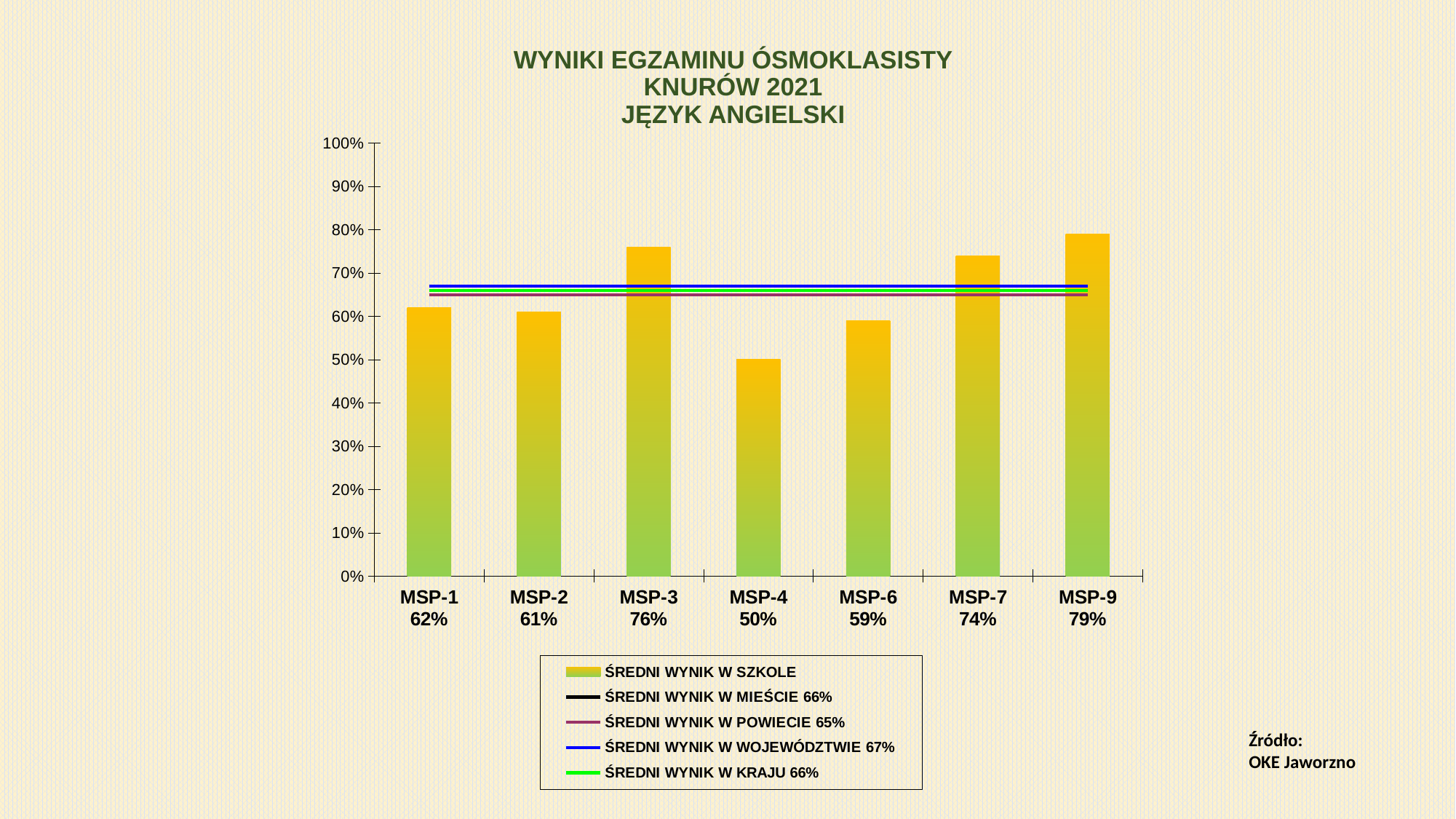
What is the average school result for MSP-3? 76% What is the difference between the results of MSP-9 and MSP-4? 29% What is the average school result for MSP-6? 59% Which school has the highest average result? MSP-9 Which school has the lowest average result? MSP-4 What kind of chart is shown on the slide? bar chart What is the average result in the voivodeship (ŚREDNI WYNIK W WOJEWÓDZTWIE) according to the legend? 67% Is the value for MSP-1 greater or less than 70%? less Which school has a higher result, MSP-7 or MSP-2? MSP-7 How many schools are shown on the x axis? 7 How many series does the legend list? 5 What is the source given for the data on the slide? OKE Jaworzno